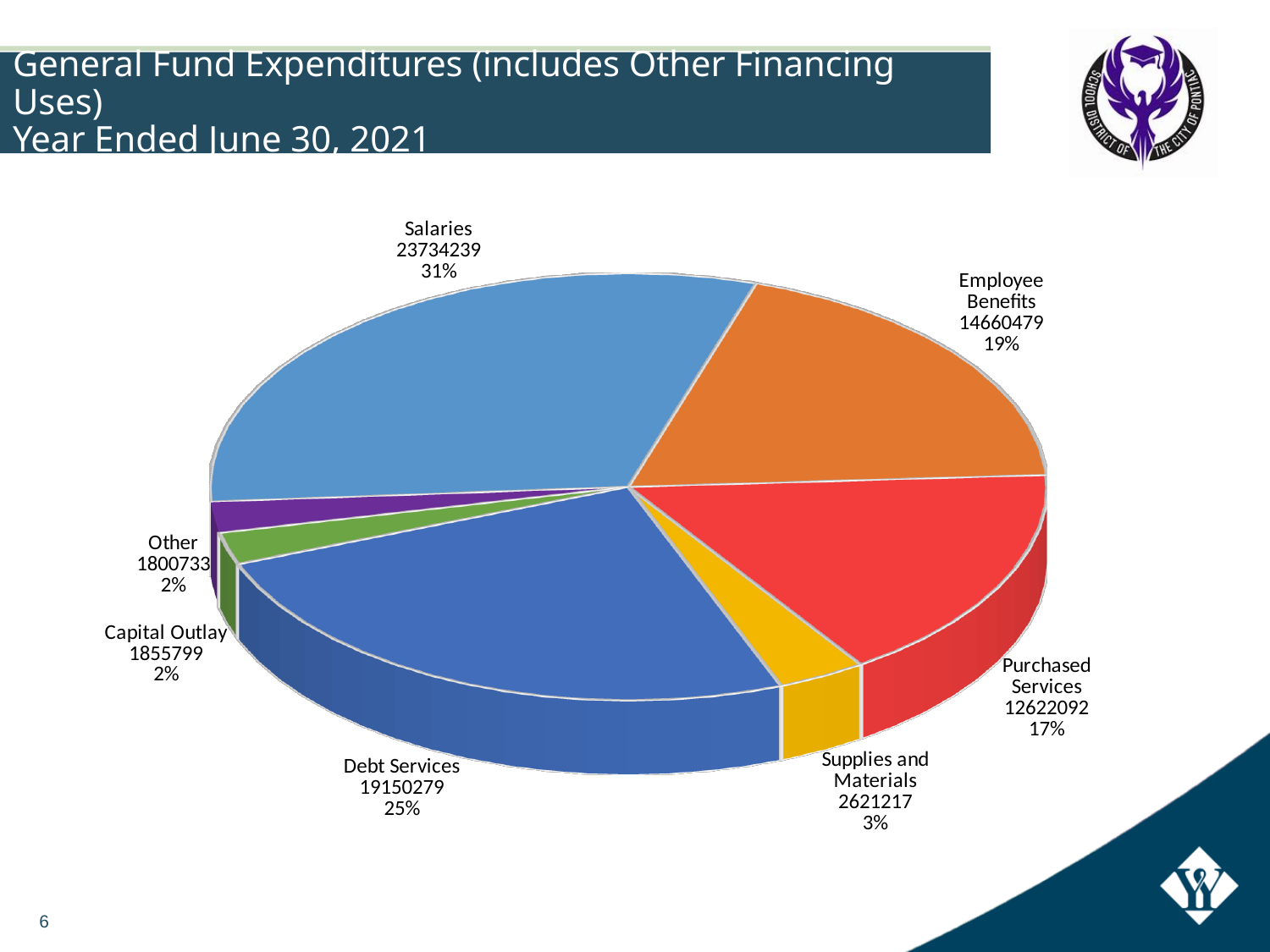
What type of chart is shown on the slide? Pie chart What is the value for Supplies and Materials? 2621217 What is the difference between Salaries and Debt Services? 4583960 Which is larger, Debt Services or Employee Benefits? Debt Services What percentage share does Employee Benefits have? 19% What percentage share does Purchased Services have? 17% What is the difference between Employee Benefits and Purchased Services? 2038387 Which category has the smallest value? Other What is the value for Debt Services? 19150279 What is the value for Salaries? 23734239 Which category has the largest value? Salaries How many categories are shown in the pie chart? 7